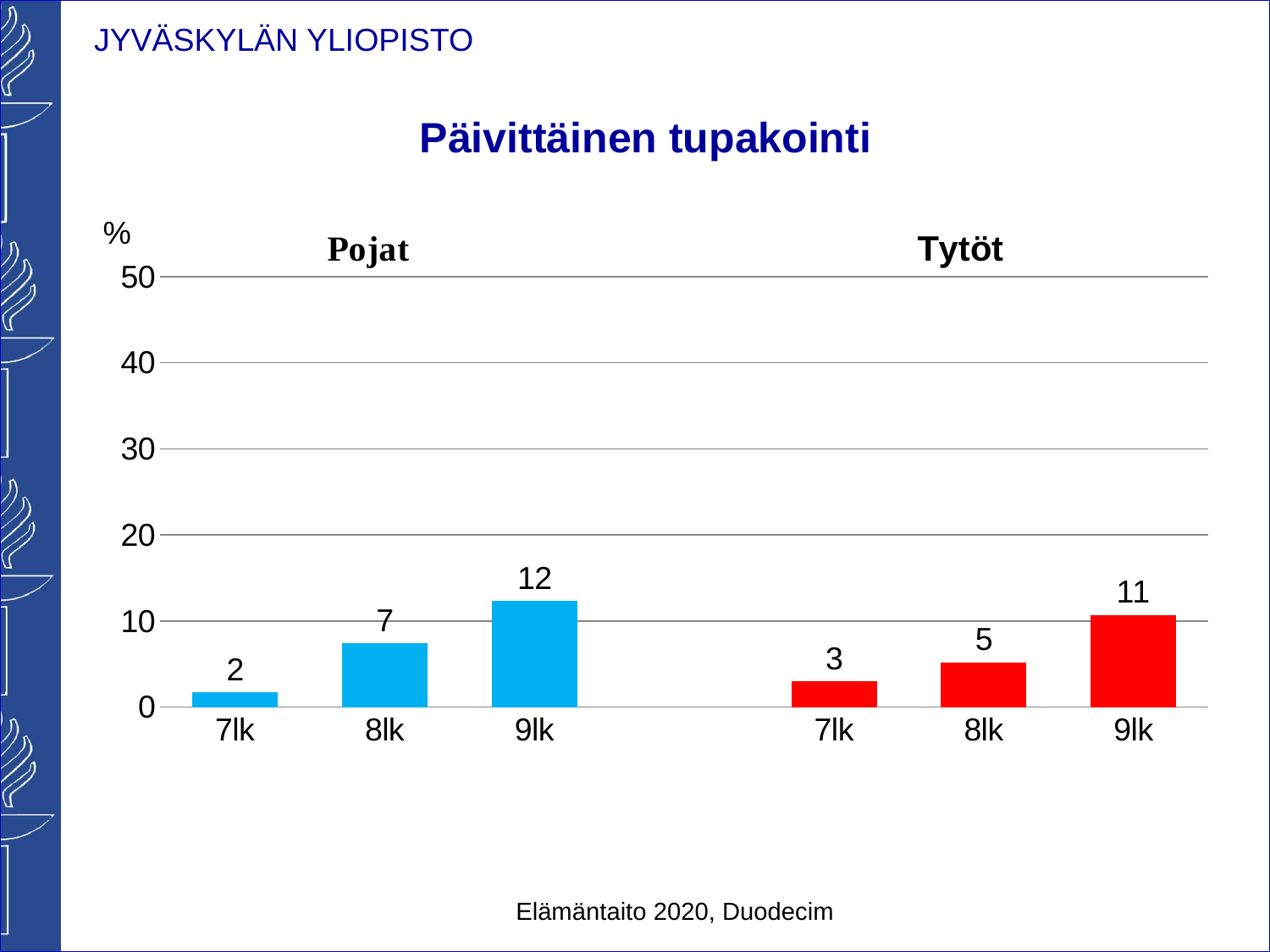
What is the value for Tytöt 7lk? 3 Do the values for Tytöt rise or fall from 7lk to 9lk? Rise What is the value for Tytöt 8lk? 5 What is the difference between the Pojat 9lk value and the Tytöt 9lk value? 1 What is the difference between the Pojat 8lk value and the Tytöt 8lk value? 2 Which bar has the highest value on the chart? Pojat 9lk How many bars are plotted on the chart? 6 Which is larger, the value for Pojat 8lk or Tytöt 8lk? Pojat 8lk What kind of chart is shown on the slide? Bar chart What is the value for Pojat 7lk? 2 Which bar has the lowest value on the chart? Pojat 7lk What is the value for Pojat 9lk? 12